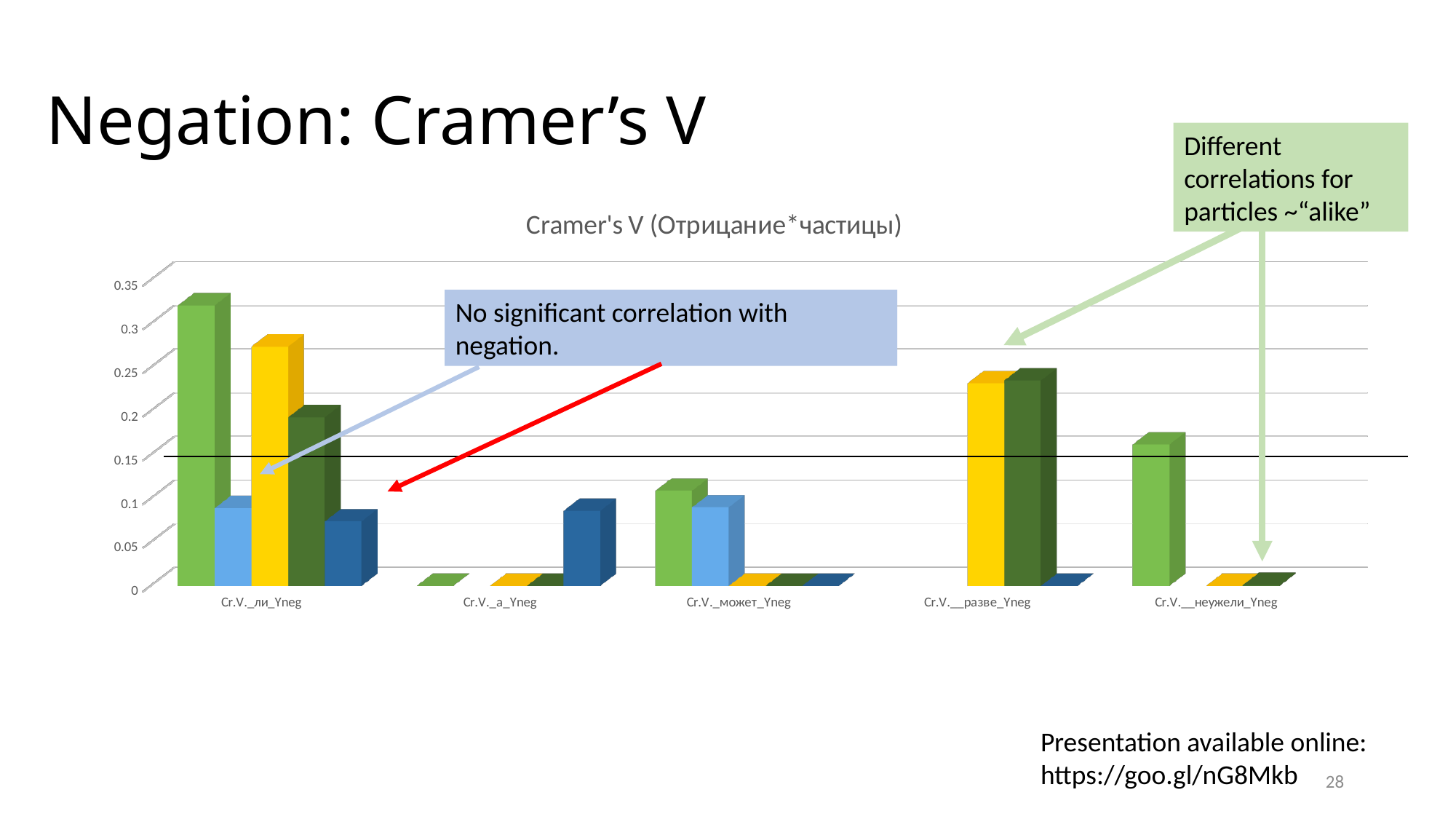
Is the value of the light green bar for Cr.V.__неужели_Yneg greater or less than 0.2? less Which is larger: the light green bar for Cr.V._ли_Yneg or the light green bar for Cr.V._может_Yneg? Cr.V._ли_Yneg What kind of chart is shown on the slide? Bar chart Is the value of the light green bar for Cr.V._ли_Yneg greater or less than 0.25? greater Which is larger: the yellow bar for Cr.V._ли_Yneg or the yellow bar for Cr.V.__разве_Yneg? Cr.V._ли_Yneg At what value on the y axis is the horizontal black line drawn across the chart? 0.15 Is the value of the dark blue bar for Cr.V._а_Yneg greater or less than 0.15? less How many categories are shown along the x axis of the chart? 5 What is the title of the chart? Cramer's V (Отрицание*частицы) Which category contains the tallest bar in the chart? Cr.V._ли_Yneg How many bars are plotted for the category Cr.V._ли_Yneg? 5